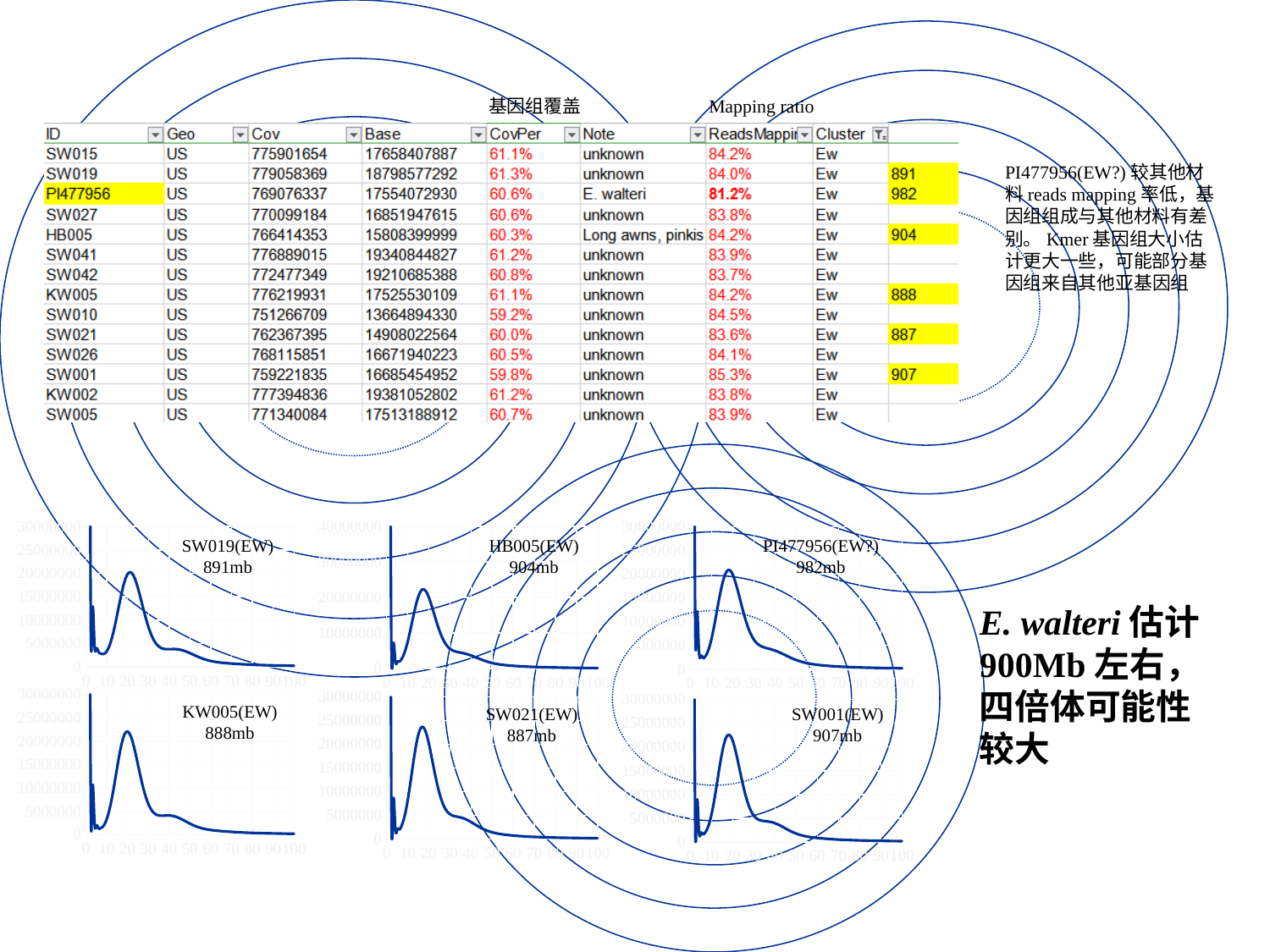
What genome size estimate is printed on the SW019(EW) chart? 891mb What genome size estimate is printed on the PI477956(EW?) chart? 982mb On the SW019(EW) chart, is the x-axis position of the main peak of the curve greater or less than 10? greater What is the difference between the genome size estimates printed on the SW001(EW) chart and the SW021(EW) chart? 20mb What is the highest y-axis tick label shown on the HB005(EW) chart? 40000000 How many k-mer distribution charts are shown on the slide? 6 What genome size estimate is printed on the SW001(EW) chart? 907mb What genome size estimate is printed on the HB005(EW) chart? 904mb What kind of chart is the SW019(EW) chart at the lower left of the slide? line chart Which of the six charts shows the largest genome size estimate? PI477956(EW?) Which of the six charts shows the smallest genome size estimate? SW021(EW) Which genome size estimate is larger, the one on the KW005(EW) chart or the one on the HB005(EW) chart? HB005(EW)